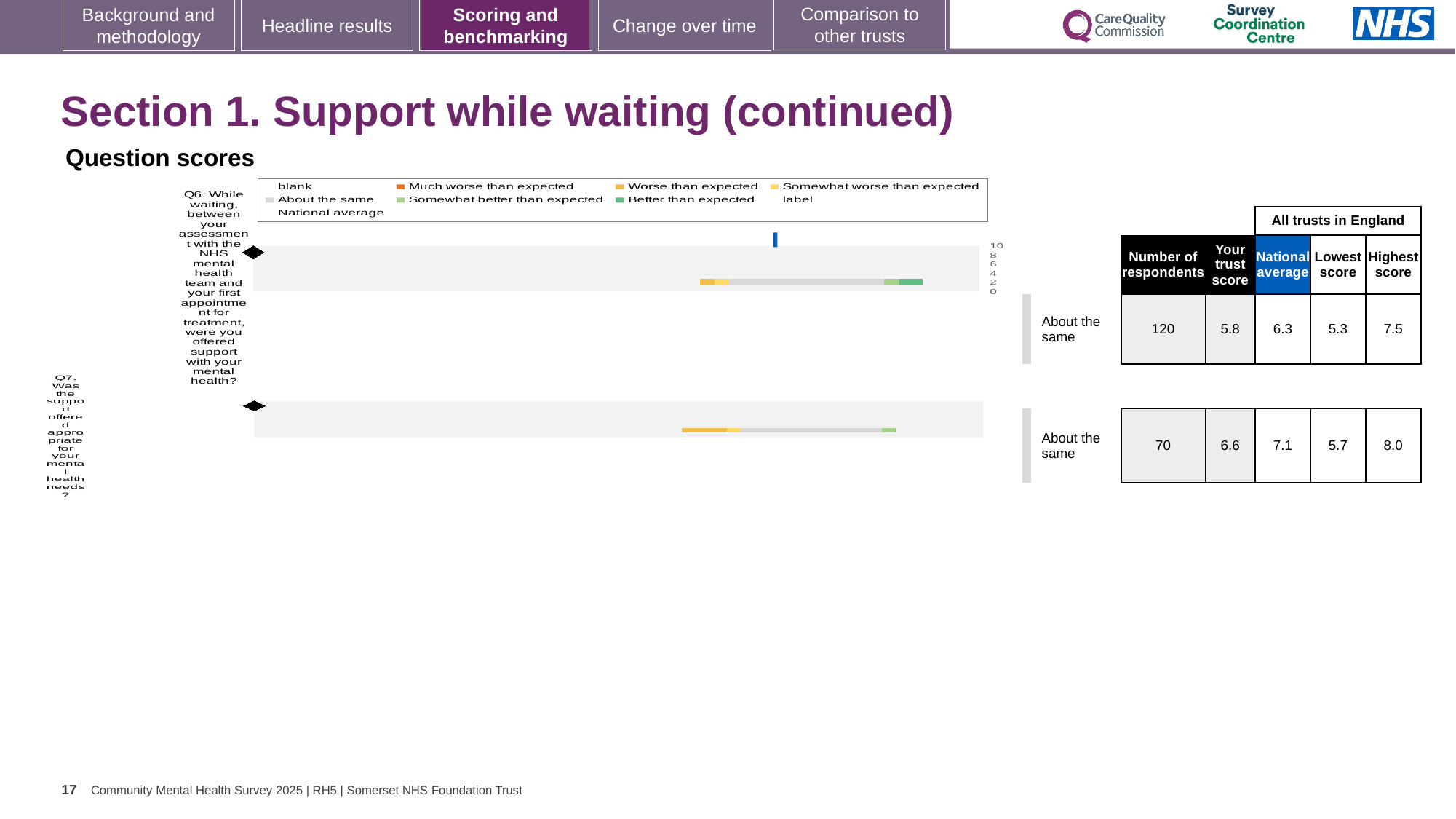
Which question has the higher trust score, Q6 or Q7? Q7 What is the lowest score among all trusts in England for Q6? 5.3 What benchmark category is shown for the trust's Q7 score? About the same What is the national average score for Q7 (was the support offered appropriate)? 7.1 What is the difference between the highest and lowest scores for Q6 across all trusts in England? 2.2 How many respondents answered Q6? 120 What kind of chart is used to show the question scores? Bar chart Which question has more respondents, Q6 or Q7? Q6 How many questions are plotted in the chart? 2 By how much does the national average for Q7 exceed the trust's score for Q7? 0.5 What is the highest score among all trusts in England for Q7? 8.0 What is the trust score for Q6 (support with mental health while waiting)? 5.8